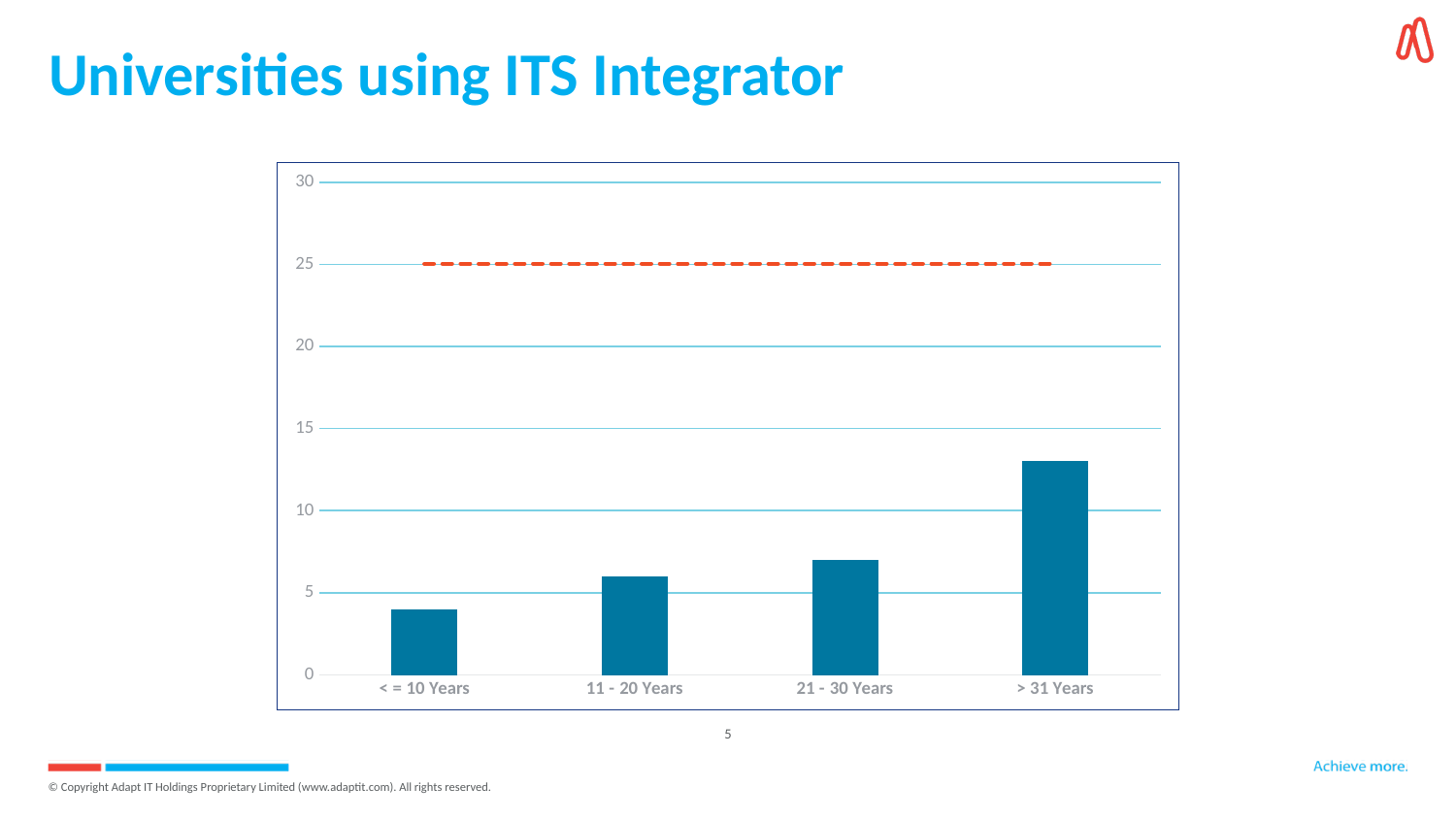
How many categories are shown on the x axis of the chart? 4 Which category has the lowest bar? < = 10 Years Is the value for 21 - 30 Years greater or less than 10? less Is the value for > 31 Years greater or less than 15? less Do the bar values rise or fall from left to right along the x axis? rise What kind of chart is shown on the slide? bar chart Is the value for > 31 Years greater or less than 10? greater At what value on the y axis is the dashed red horizontal line drawn? 25 Which is larger, the value for < = 10 Years or the value for > 31 Years? > 31 Years Which is larger, the value for 11 - 20 Years or the value for > 31 Years? > 31 Years Which category has the highest bar? > 31 Years